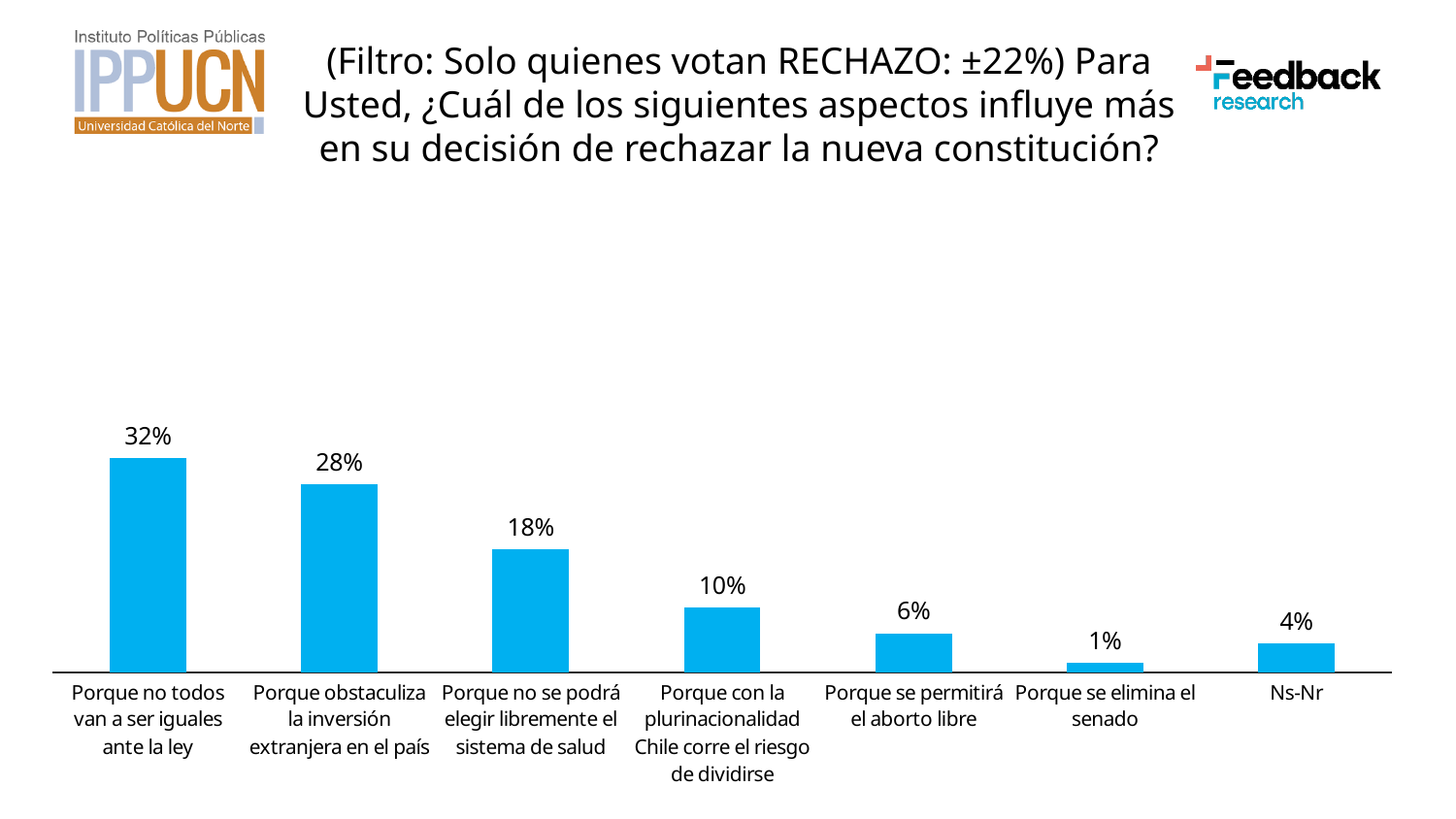
What is the value for the "Ns-Nr" category? 4% What kind of chart is shown on the slide? Bar chart How many categories are shown in the chart? 7 What percentage is shown for "Porque se permitirá el aborto libre"? 6% Which category has the lowest value? Porque se elimina el senado Do the values generally rise or fall from left to right across the first six categories? Fall Which category has the highest value? Porque no todos van a ser iguales ante la ley Which is larger: the value for "Porque se permitirá el aborto libre" or the value for "Ns-Nr"? Porque se permitirá el aborto libre What is the difference between "Porque no todos van a ser iguales ante la ley" and "Porque obstaculiza la inversión extranjera en el país"? 4% What is the difference between "Porque no se podrá elegir libremente el sistema de salud" and "Porque con la plurinacionalidad Chile corre el riesgo de dividirse"? 8% What is the value for "Porque obstaculiza la inversión extranjera en el país"? 28% What percentage of respondents chose "Porque no todos van a ser iguales ante la ley"? 32%